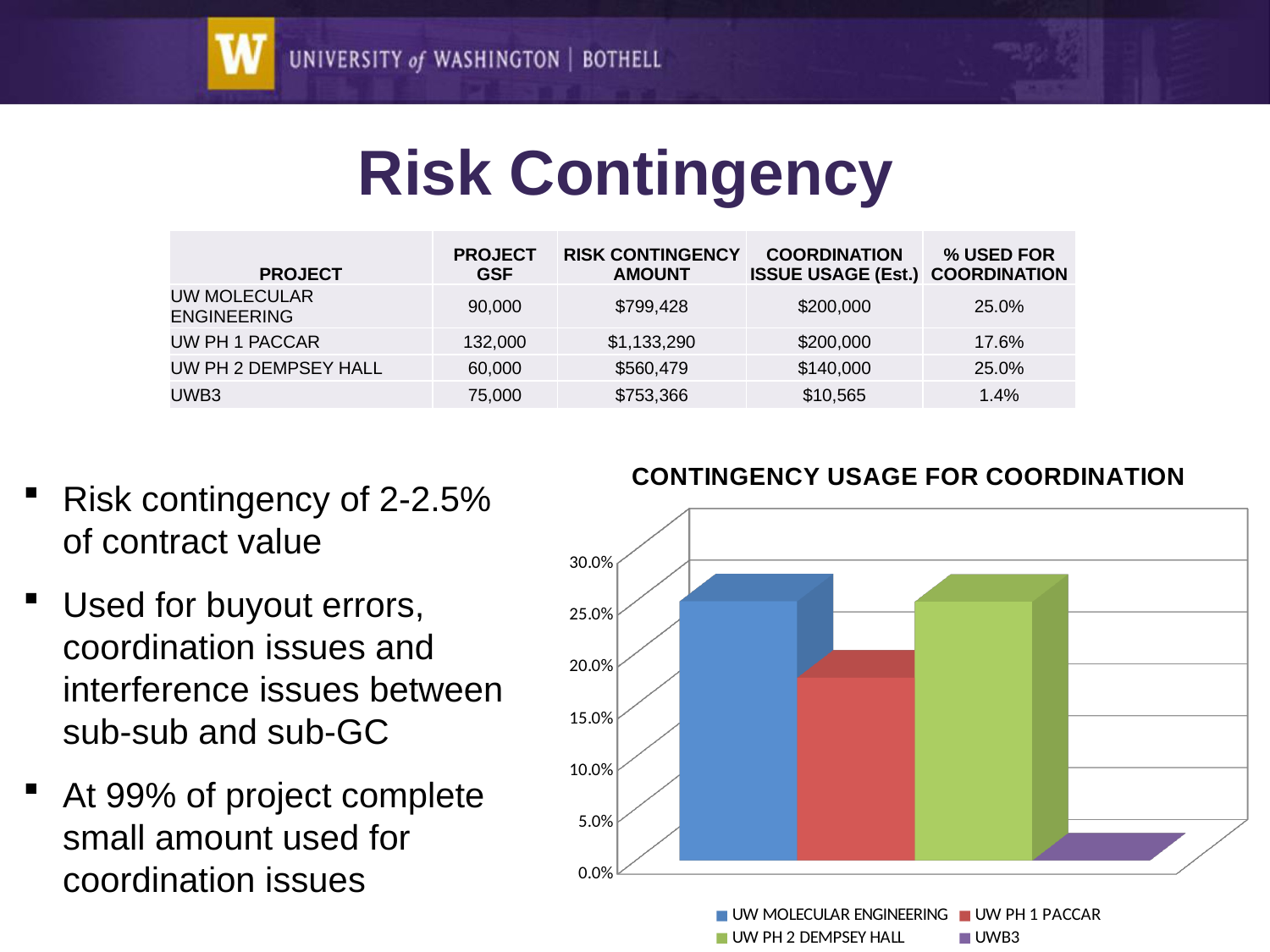
In the chart, is the value for UW PH 2 DEMPSEY HALL greater or less than 20.0%? greater What colour is the bar for UWB3 in the chart? purple How many bars are plotted in the chart? 4 How many series does the legend of the chart list? 4 What kind of chart is shown under the title "CONTINGENCY USAGE FOR COORDINATION"? bar chart In the chart, which is larger: the bar for UW MOLECULAR ENGINEERING or the bar for UW PH 1 PACCAR? UW MOLECULAR ENGINEERING In the chart, is the value for UW MOLECULAR ENGINEERING greater or less than 20.0%? greater In the chart, is the value for UWB3 greater or less than 5.0%? less In the chart, which is larger: the bar for UW PH 1 PACCAR or the bar for UWB3? UW PH 1 PACCAR Which project has the lowest bar in the chart? UWB3 What is the title of the chart on the slide? CONTINGENCY USAGE FOR COORDINATION